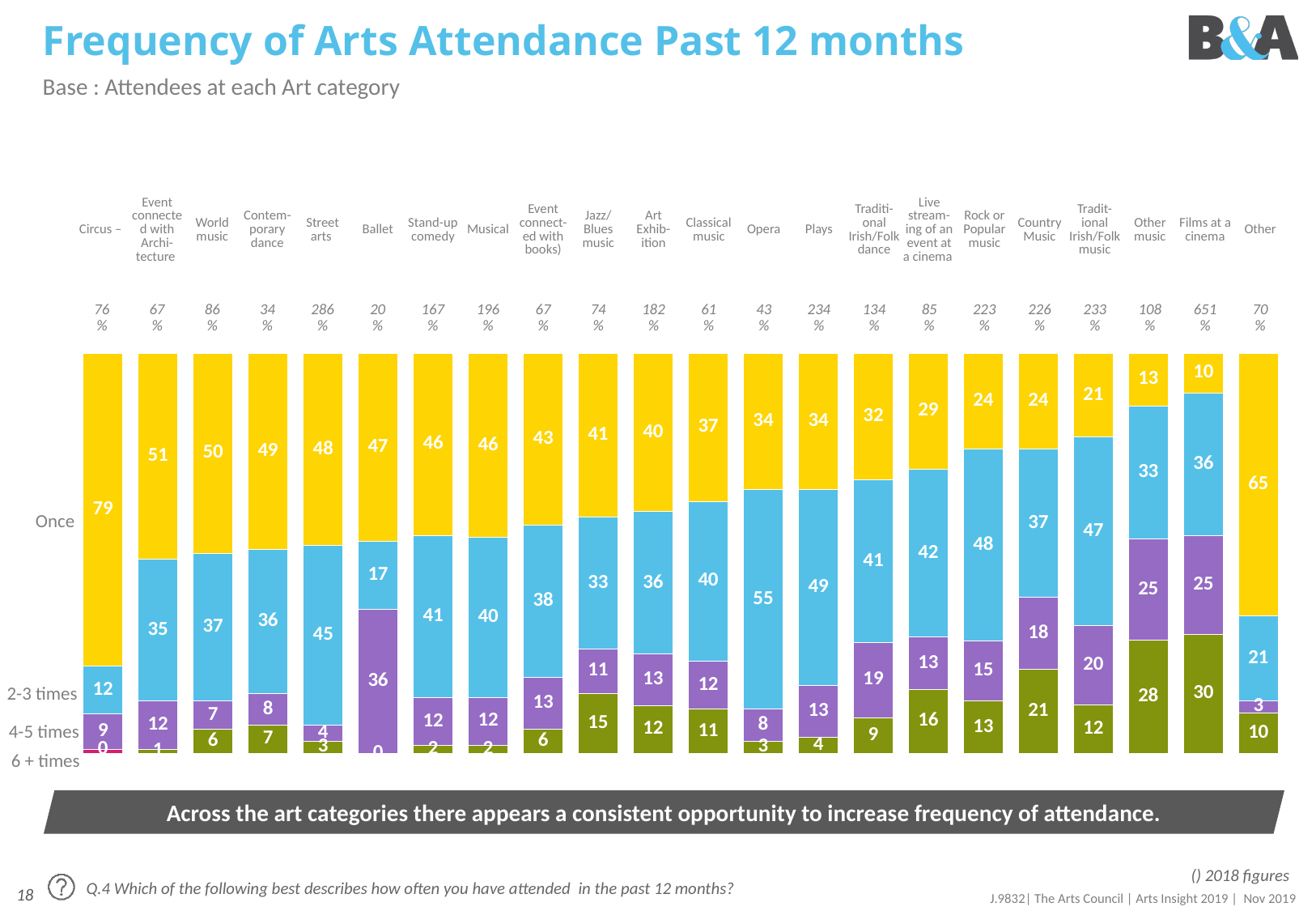
Which art category has the highest '6 + times' value? Films at a cinema How many art categories are shown in the chart? 22 What is the value for '2-3 times' for Opera? 55 What is the total of the Circus bar across all four frequency bands? 100 Which art category has the highest 'Once' value? Circus Which art category has the lowest 'Once' value? Films at a cinema What is the value for '4-5 times' for Ballet? 36 What kind of chart is shown on the slide? Stacked bar chart What is the value for '6 + times' for Films at a cinema? 30 What percentage of Circus attendees attended once in the past 12 months? 79 Which has a larger '2-3 times' value, Opera or Plays? Opera What is the difference between the 'Once' value for Circus and the 'Once' value for Other? 14